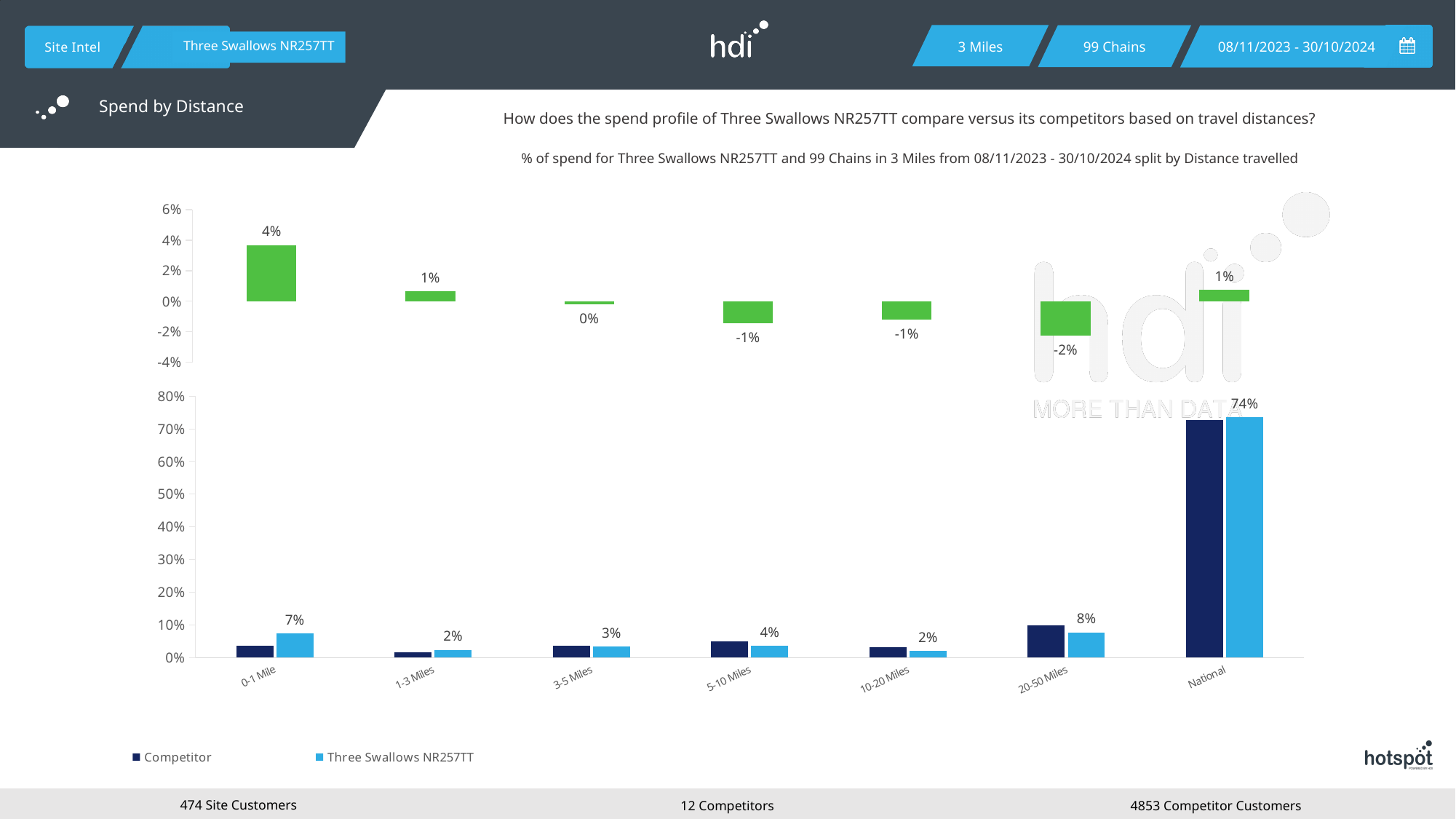
In the top chart, which category has the lowest value? 20-50 Miles In the top chart, which category has the highest value? 0-1 Mile In the bottom chart, what is the value for Three Swallows NR257TT in the 20-50 Miles category? 8% How many distance categories are shown on the x axis of the bottom chart? 7 In the bottom chart, what is the difference between the Three Swallows NR257TT values for National and 20-50 Miles? 66% In the bottom chart, which category has the highest value for Three Swallows NR257TT? National In the bottom chart, is the Competitor value for National greater or less than 60%? greater How many series does the legend of the bottom chart list? 2 In the bottom chart, what is the value for Three Swallows NR257TT in the 0-1 Mile category? 7% In the top chart, what is the value shown for the 20-50 Miles category? -2% In the top chart, what is the value shown for the 0-1 Mile category? 4% In the bottom chart, what is the value for Three Swallows NR257TT in the National category? 74%